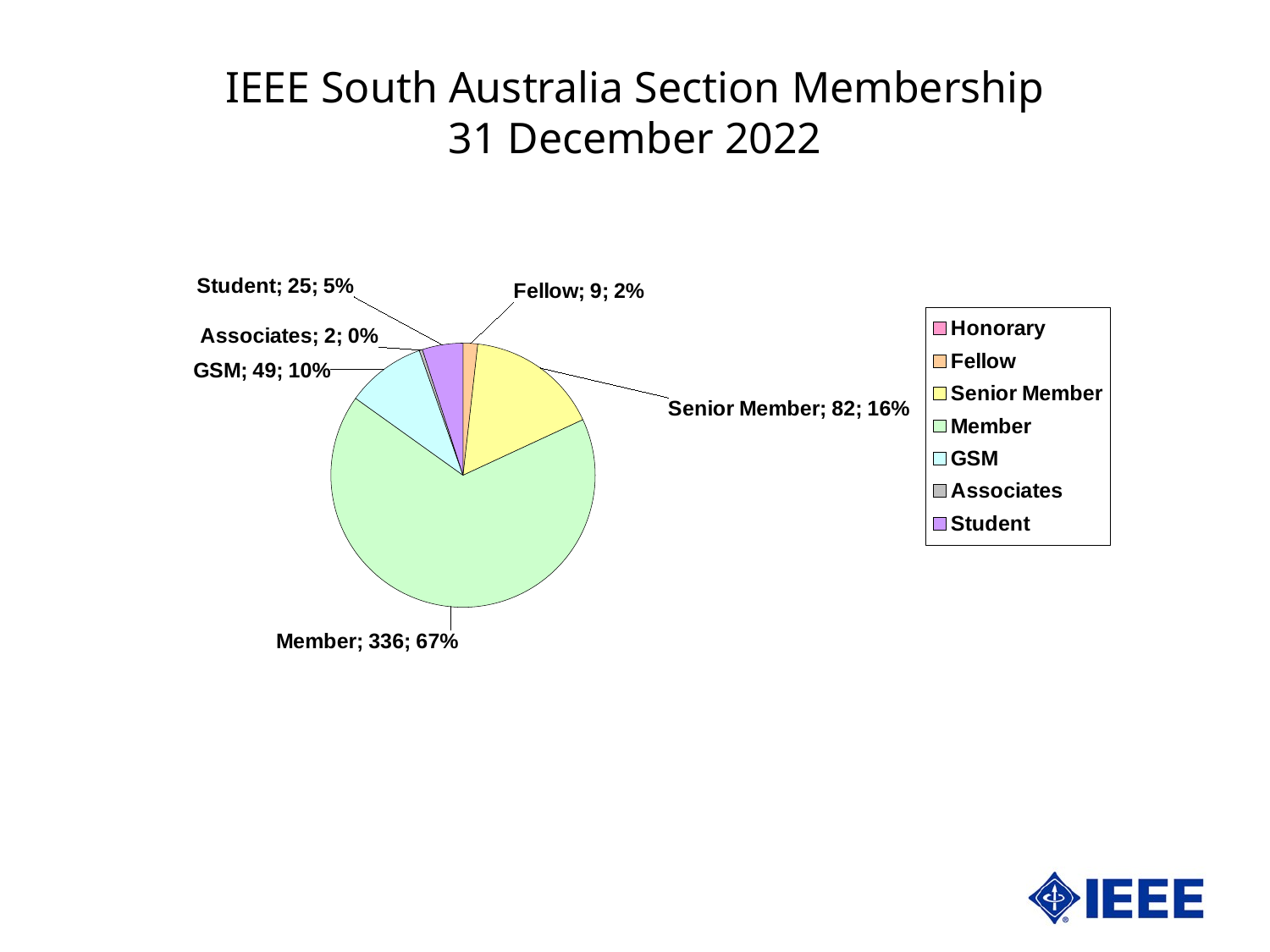
What is the value for GSM? 49 What is the value for Fellow? 9 What is the difference between the Member and Senior Member values? 254 What is the value for Senior Member? 82 How many members are in the Member category? 336 What is the title of the chart? IEEE South Australia Section Membership 31 December 2022 What share of the pie does Senior Member represent? 16% Which is larger, the value for GSM or the value for Student? GSM How many entries does the legend list? 7 What share of the pie does Member represent? 67% Which category has the largest slice of the pie? Member What kind of chart is shown on the slide? Pie chart